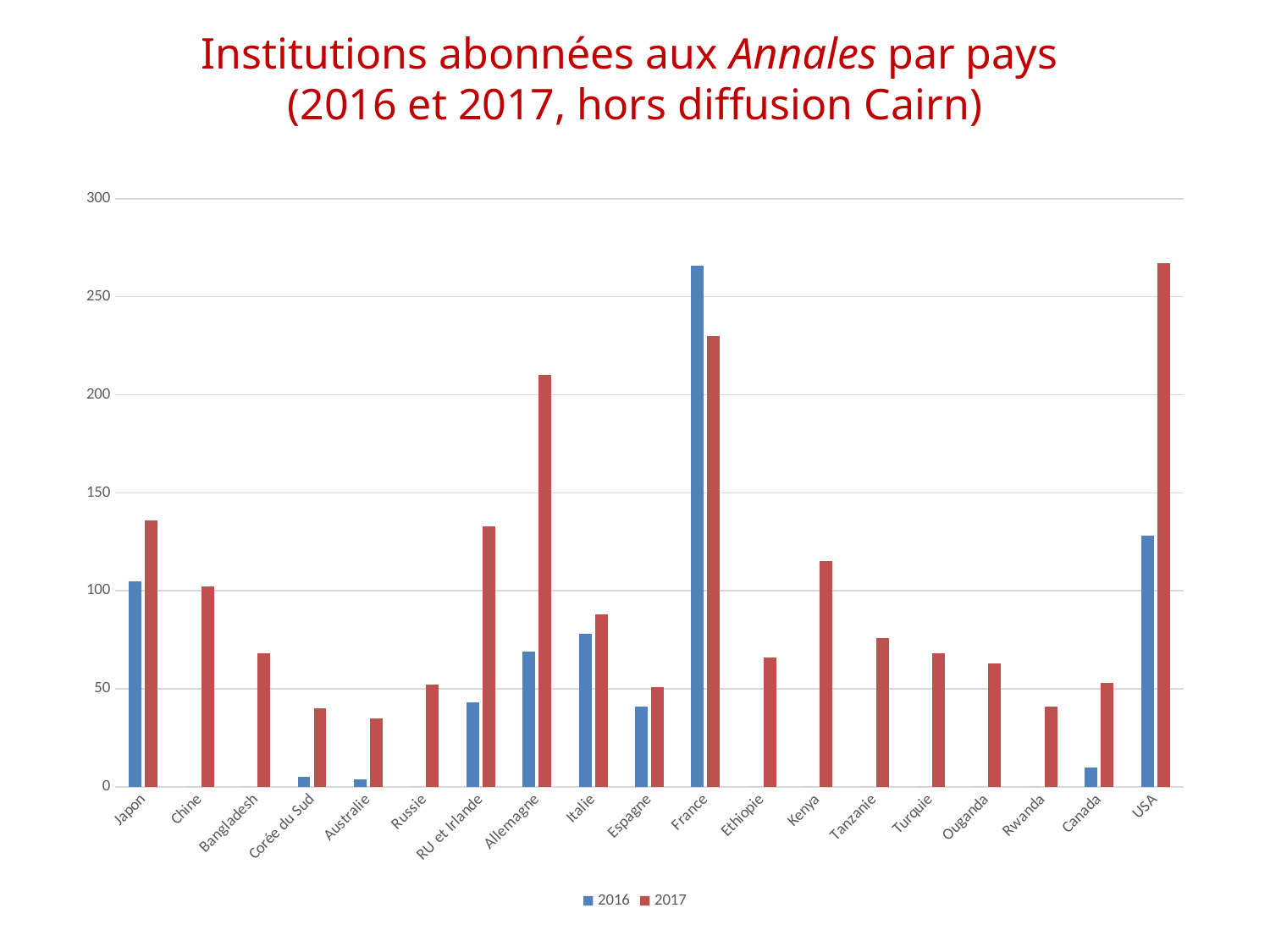
What kind of chart is shown on the slide? bar chart Is the 2016 value for Canada greater or less than 50? less Is the 2017 value for Kenya greater or less than 100? greater Is the 2016 value for France greater or less than 250? greater How many countries are shown on the x axis? 19 For France, which year has the larger value, 2016 or 2017? 2016 How many series does the legend list? 2 Which country has the highest value for 2016? France Which country has the highest value for 2017? USA For USA, which year has the larger value, 2016 or 2017? 2017 Which colour represents the 2017 series in the legend? red